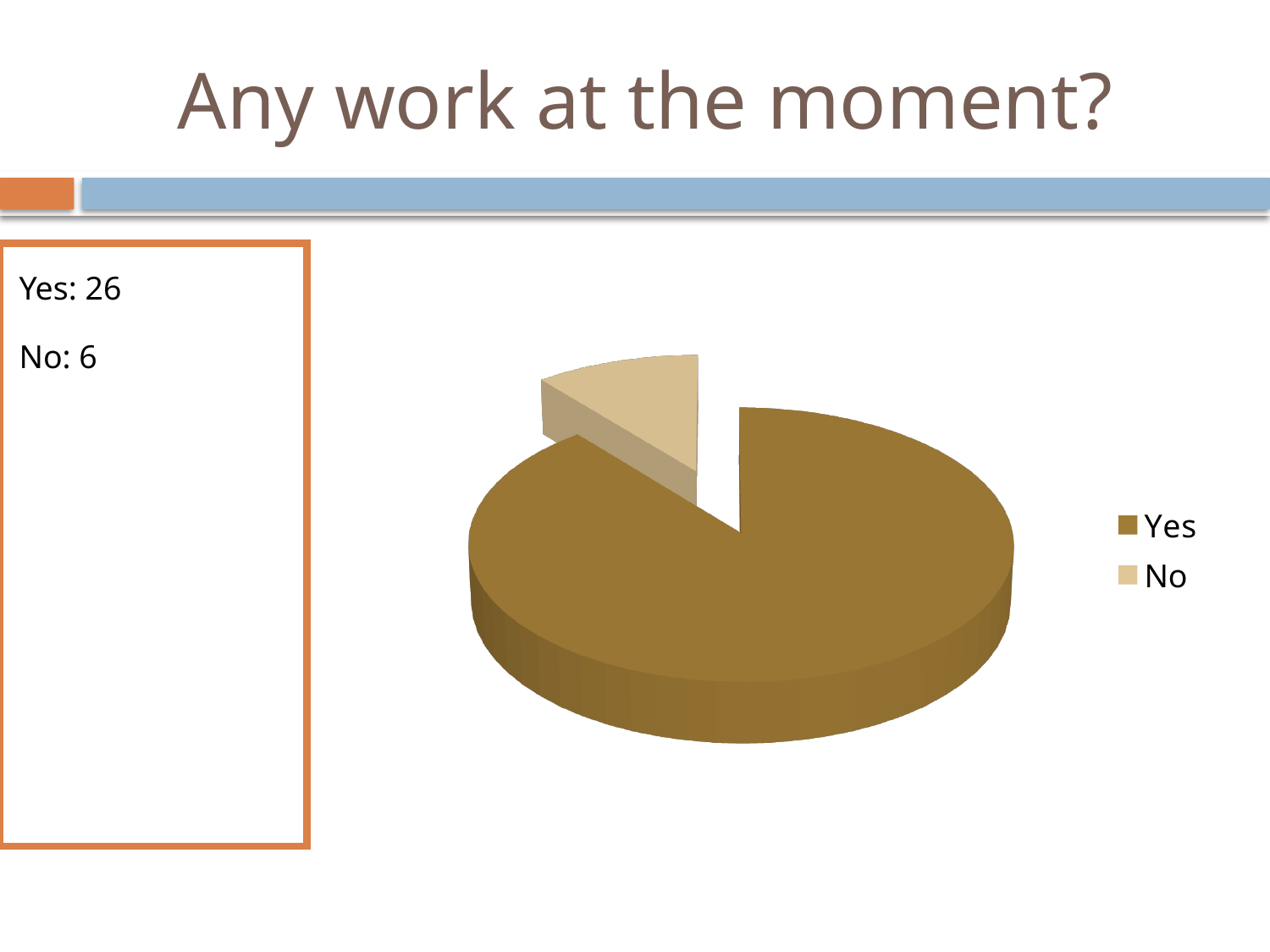
Which category has the largest slice of the pie? Yes What kind of chart is shown on the slide? pie chart Which is larger, the value for Yes or the value for No? Yes What is the total of the values for Yes and No? 32 What is the difference between the value for Yes and the value for No? 20 What is the value for Yes? 26 Which category has the smallest slice of the pie? No What is the title of the slide containing the pie chart? Any work at the moment? How many slices does the pie chart have? 2 What is the value for No? 6 What share of the pie does the No slice represent? 18.75% How many entries does the legend of the pie chart list? 2